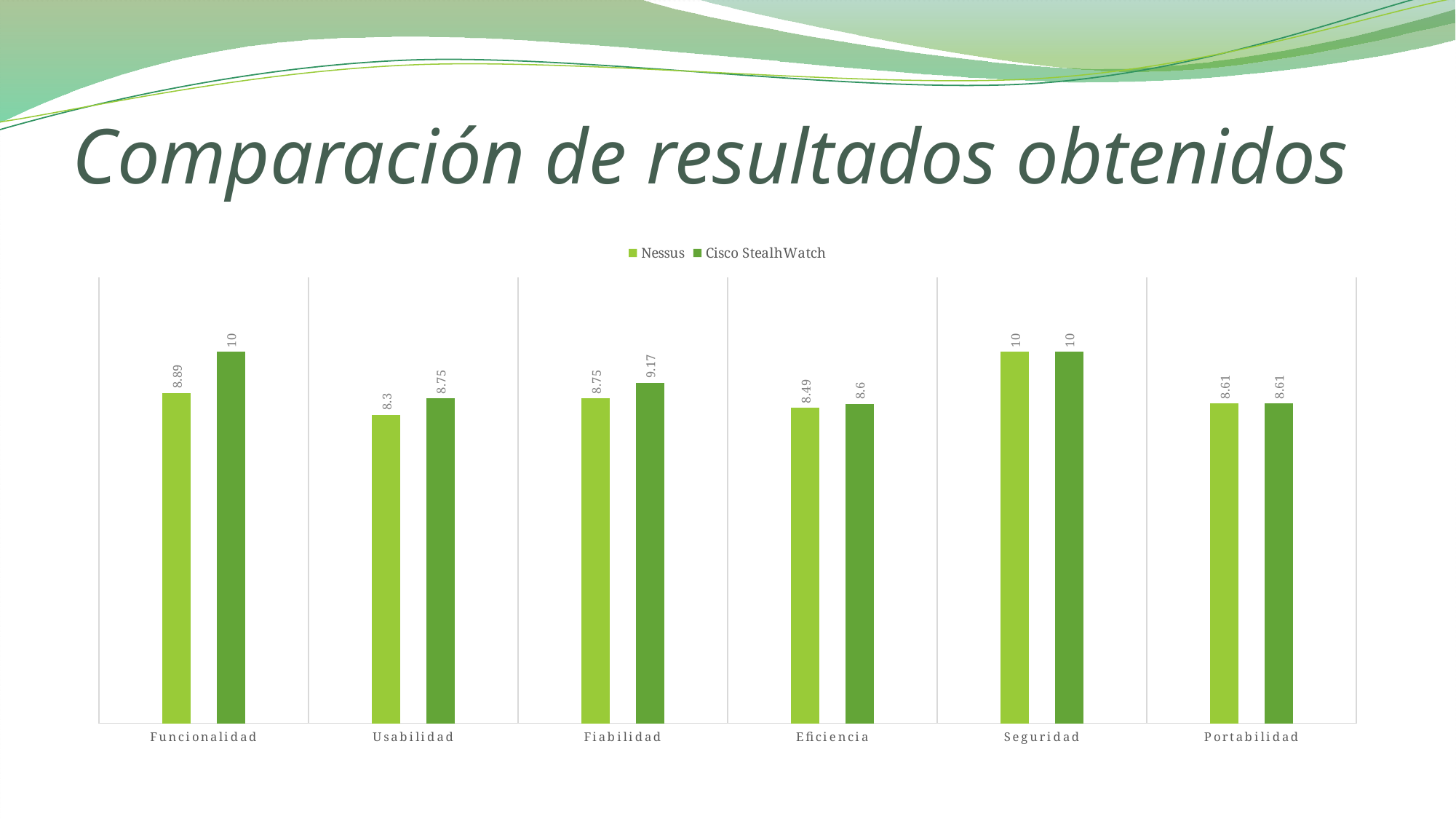
What is the difference between the Cisco StealhWatch and Nessus values for Funcionalidad? 1.11 Which is larger for Fiabilidad, the Nessus value or the Cisco StealhWatch value? Cisco StealhWatch What kind of chart is shown on the slide? Bar chart What is the difference between the Cisco StealhWatch and Nessus values for Usabilidad? 0.45 What is the Cisco StealhWatch value for Fiabilidad? 9.17 Which category has the lowest Nessus value? Usabilidad Which category has the highest Nessus value? Seguridad What is the Nessus value for Usabilidad? 8.3 How many categories are shown on the x axis? 6 What is the Cisco StealhWatch value for Eficiencia? 8.6 How many series does the legend list? 2 What is the Nessus value for Funcionalidad? 8.89